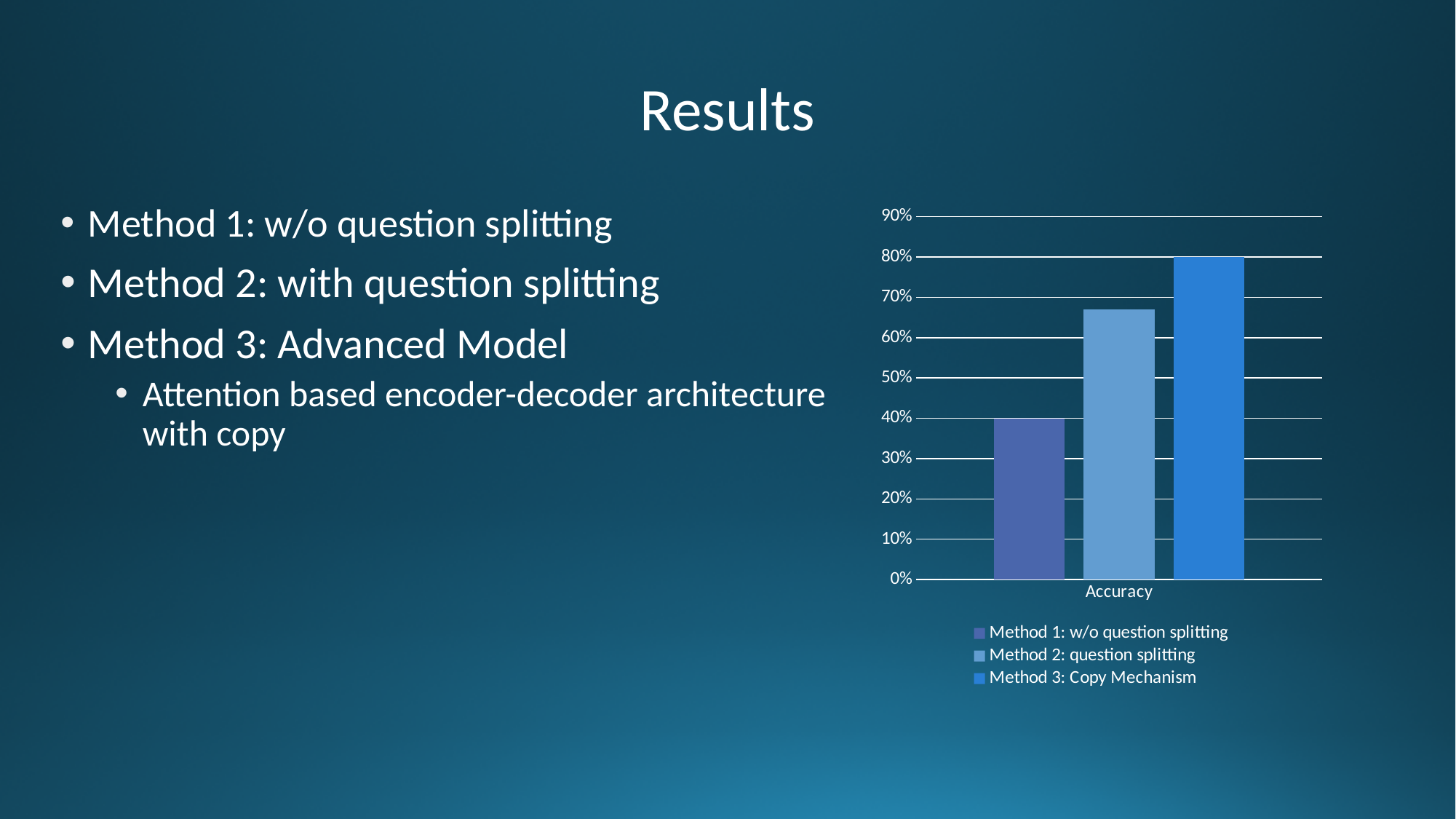
What kind of chart is shown on the slide? Bar chart Is the accuracy for Method 2: question splitting greater or less than 70%? less Which method has the highest accuracy? Method 3: Copy Mechanism Is the accuracy for Method 2: question splitting greater or less than 60%? greater What is the accuracy for Method 1: w/o question splitting? 40% How many categories are shown on the x axis of the chart? 1 How many series does the chart legend list? 3 What is the label of the category on the x axis of the chart? Accuracy What is the accuracy for Method 3: Copy Mechanism? 80% Which has higher accuracy, Method 2: question splitting or Method 3: Copy Mechanism? Method 3: Copy Mechanism What is the difference in accuracy between Method 3: Copy Mechanism and Method 1: w/o question splitting? 40% Which method has the lowest accuracy? Method 1: w/o question splitting